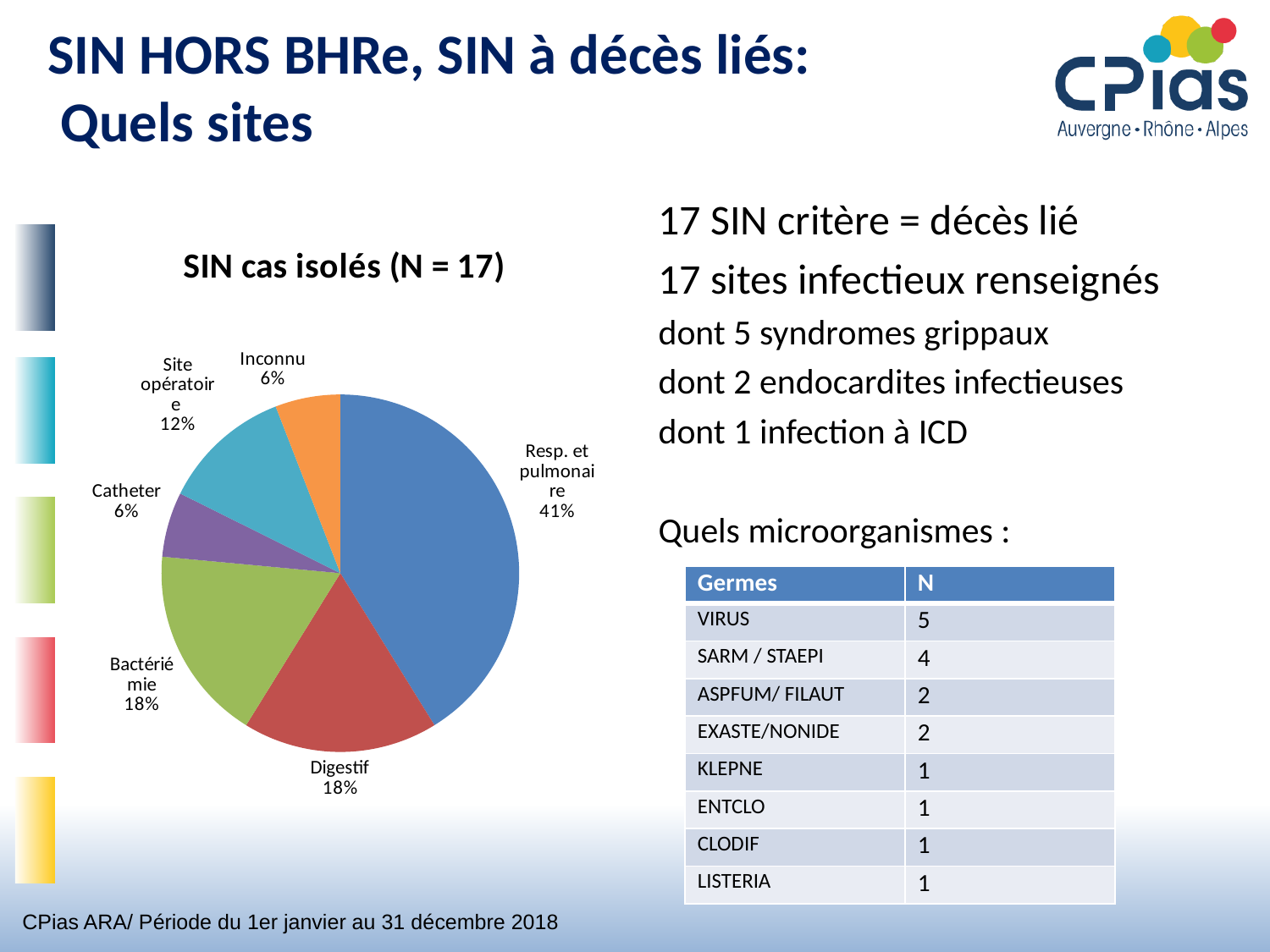
What percentage is shown for "Catheter"? 6% What is the total N stated in the pie chart title? 17 Which is larger, the share for "Site opératoire" or the share for "Catheter"? Site opératoire Which category has the largest slice of the pie? Resp. et pulmonaire What is the difference in percentage points between "Resp. et pulmonaire" and "Bactériémie"? 23 What percentage is shown for "Digestif"? 18% What is the title of the pie chart? SIN cas isolés (N = 17) What percentage is shown for "Inconnu"? 6% What percentage is shown for "Site opératoire"? 12% How many slices does the pie chart have? 6 What share of the pie does "Resp. et pulmonaire" represent? 41% What type of chart is shown on the slide? pie chart